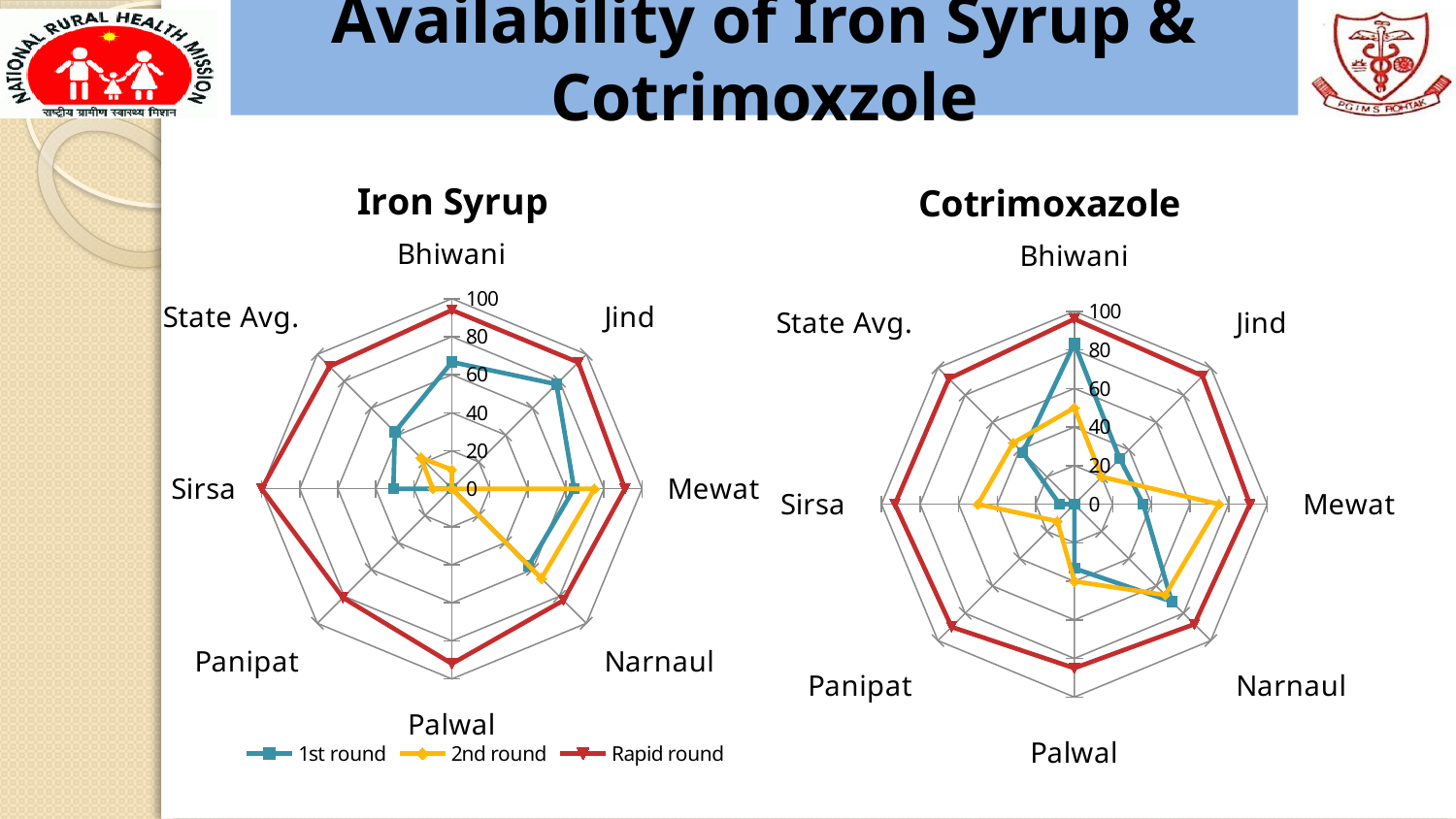
How many series does the legend list for the Iron Syrup chart? 3 On the Cotrimoxazole chart, is the 1st round value for Bhiwani greater or less than 60? greater On the Iron Syrup chart, which is larger for Bhiwani: the 1st round value or the 2nd round value? 1st round On the Iron Syrup chart, is the 2nd round value for Mewat greater or less than 60? greater How many categories (districts plus State Avg.) are plotted on the Cotrimoxazole chart? 8 On the Iron Syrup chart, is the 2nd round value for Palwal greater or less than 20? less What kind of chart is the Iron Syrup chart? Radar chart On the Cotrimoxazole chart, which is larger for Mewat: the 1st round value or the 2nd round value? 2nd round